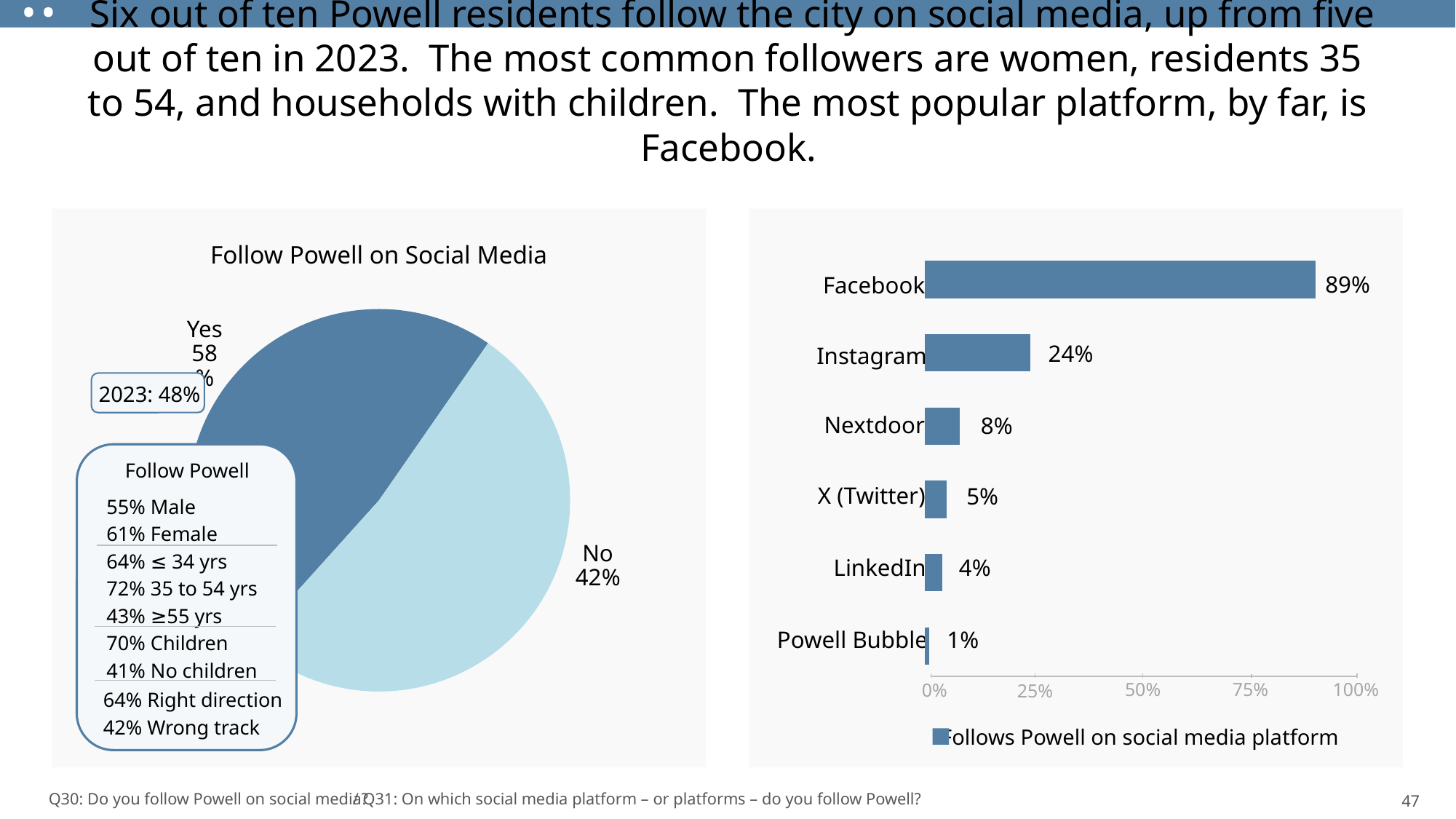
In the bar chart on the right, how many platforms are shown? 6 In the pie chart titled 'Follow Powell on Social Media', what share of residents answered No? 42% In the bar chart on the right, what is the value for LinkedIn? 4% In the bar chart on the right, what is the difference between the values for Facebook and Instagram? 65% What kind of chart is the chart on the right of the slide? Bar chart In the pie chart titled 'Follow Powell on Social Media', what share of residents answered Yes? 58% In the bar chart on the right, which platform has the highest value? Facebook In the bar chart on the right, which is larger: the value for Nextdoor or the value for X (Twitter)? Nextdoor In the bar chart on the right, what is the value for Facebook? 89% In the bar chart on the right, which platform has the lowest value? Powell Bubble What kind of chart is the chart on the left of the slide? Pie chart In the bar chart on the right, what is the value for Instagram? 24%